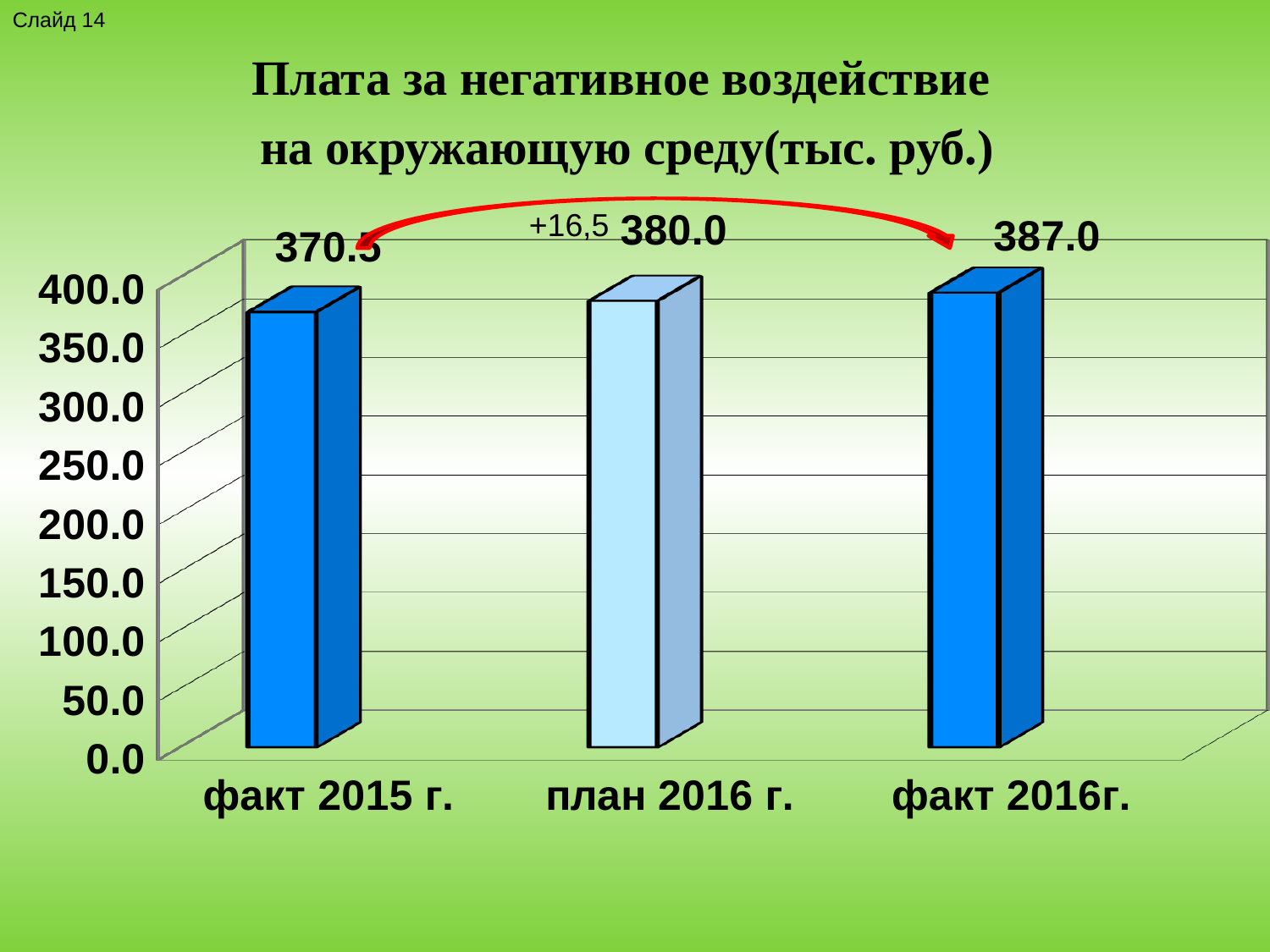
What kind of chart is shown on the slide? bar chart Which is larger, the value for план 2016 г. or the value for факт 2016г.? факт 2016г. What is the value for факт 2016г.? 387.0 Which category has the lowest value? факт 2015 г. What is the difference between the values for факт 2016г. and план 2016 г.? 7.0 Is the value for факт 2015 г. greater or less than 400.0? less Is the value for факт 2015 г. greater or less than 350.0? greater What is the title of the chart? Плата за негативное воздействие на окружающую среду(тыс. руб.) How many categories are shown on the x axis? 3 What is the value for план 2016 г.? 380.0 What change is annotated by the red arrow between факт 2015 г. and факт 2016г.? +16,5 Which category has the highest value? факт 2016г.